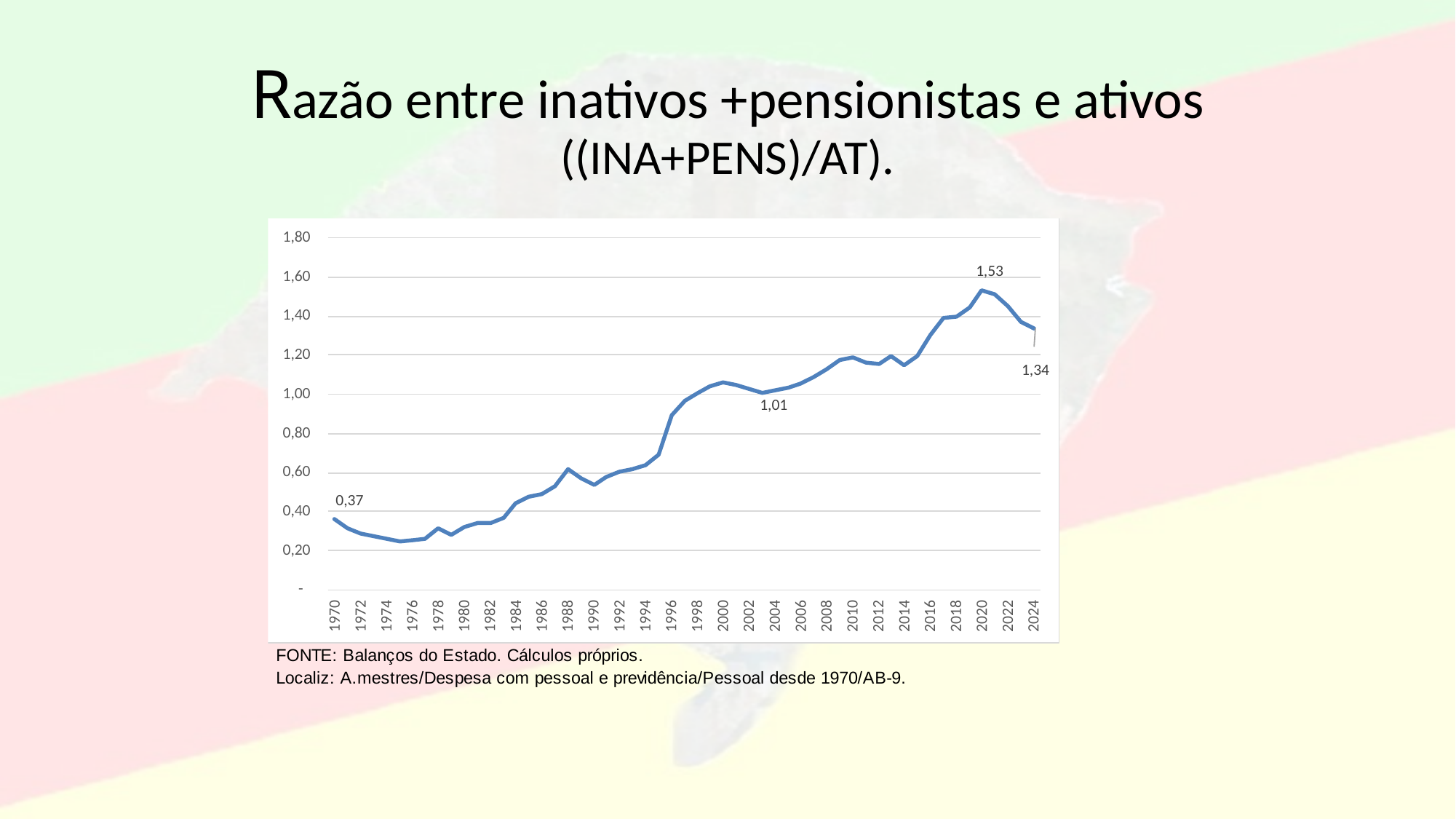
What is the difference between the 2020 value and the 1970 value? 1,16 What is the difference between the 2020 value and the 2024 value? 0,19 Which year has the larger ratio, 1970 or 2024? 2024 What is the value of the ratio in 2024? 1,34 What kind of chart is shown on the slide? line chart What is the value of the ratio in 1970? 0,37 In which year does the ratio reach its highest value? 2020 Overall, does the ratio rise or fall from 1970 to 2020? rise What is the title of the slide containing the chart? Razão entre inativos +pensionistas e ativos ((INA+PENS)/AT). What is the value of the ratio in 2020? 1,53 Is the value for 1996 greater or less than 0,80? greater Is the value for 1990 greater or less than 0,60? less